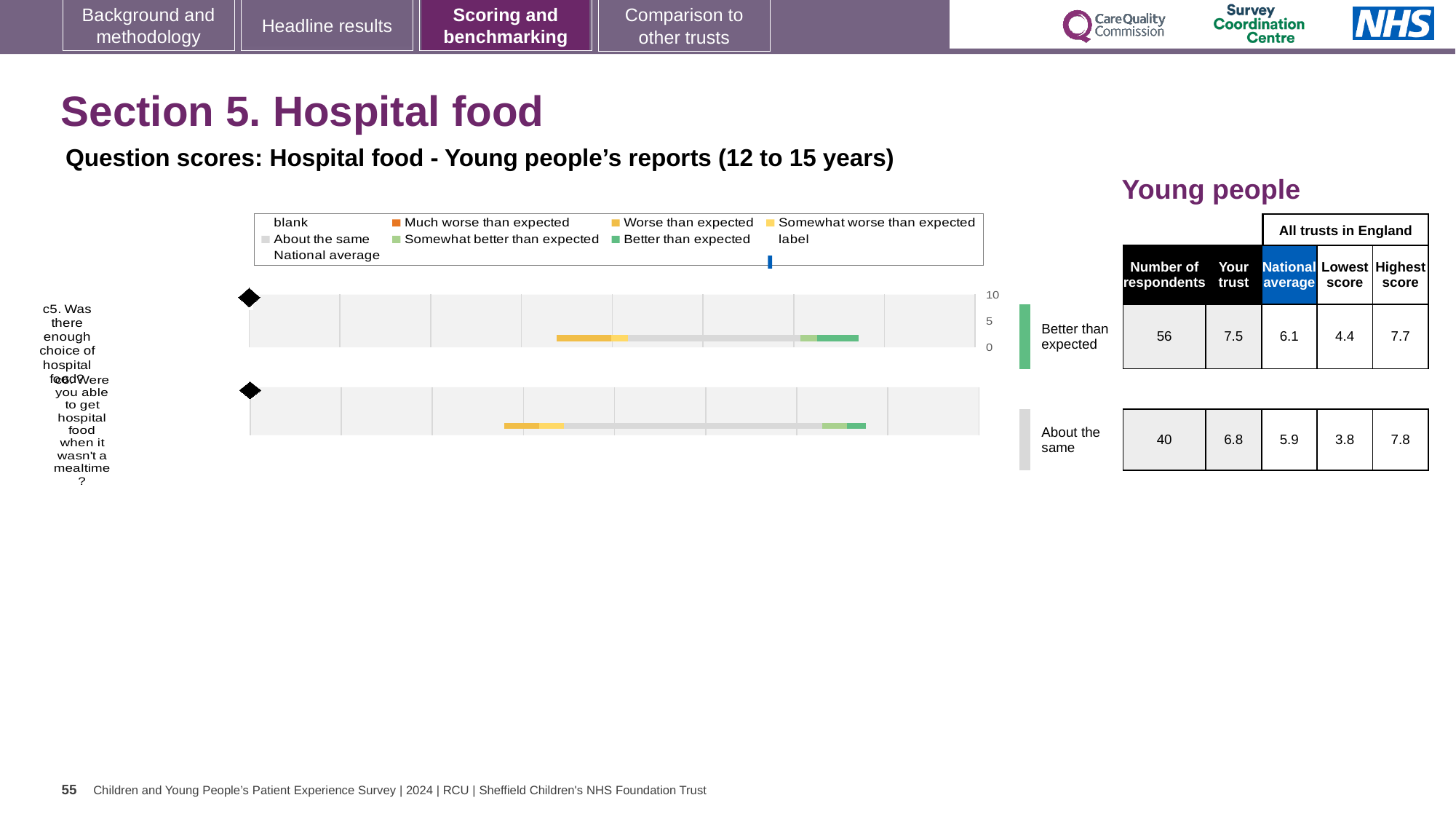
What is the lowest score among all trusts in England for question c5? 4.4 What type of chart is used to show the question scores for hospital food? bar chart What is the difference between the highest and lowest scores for question c6? 4.0 What is the 'Your trust' score for question c5 (Was there enough choice of hospital food?)? 7.5 What is the national average score for question c5? 6.1 What benchmark category is shown for question c6? About the same By how much does the trust's score for question c5 exceed the national average? 1.4 How many questions are plotted in the hospital food chart? 2 How many respondents answered question c6 (Were you able to get hospital food when it wasn't a mealtime?)? 40 Which question had more respondents, c5 or c6? c5 Which question has the higher 'Your trust' score, c5 or c6? c5 What is the highest score among all trusts in England for question c6? 7.8